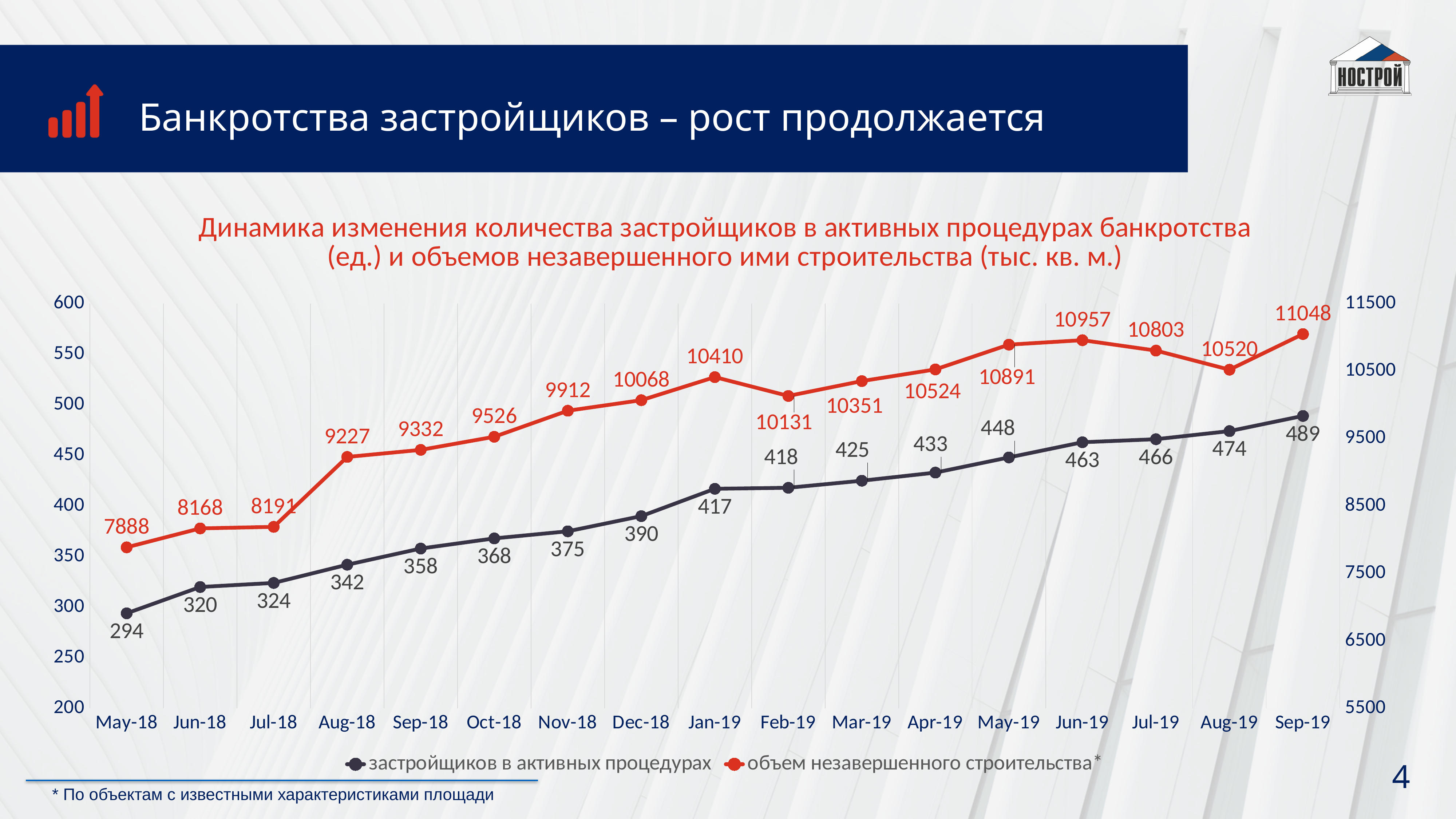
In which month is "застройщиков в активных процедурах" lowest? May-18 In which month is "объем незавершенного строительства" highest? Sep-19 Does "застройщиков в активных процедурах" generally rise or fall from May-18 to Sep-19? rise What is the difference between the "объем незавершенного строительства" values for Jan-19 and Feb-19? 279 What is the difference between the "застройщиков в активных процедурах" values for Sep-19 and May-18? 195 Which is larger for "объем незавершенного строительства": Jun-19 or Aug-19? Jun-19 What is the value of "застройщиков в активных процедурах" for Dec-18? 390 How many series does the legend list? 2 How many months are plotted along the x axis? 17 What is the value of "объем незавершенного строительства" for Jan-19? 10410 What type of chart is shown on the slide? line chart What colour is the line for "объем незавершенного строительства"? red